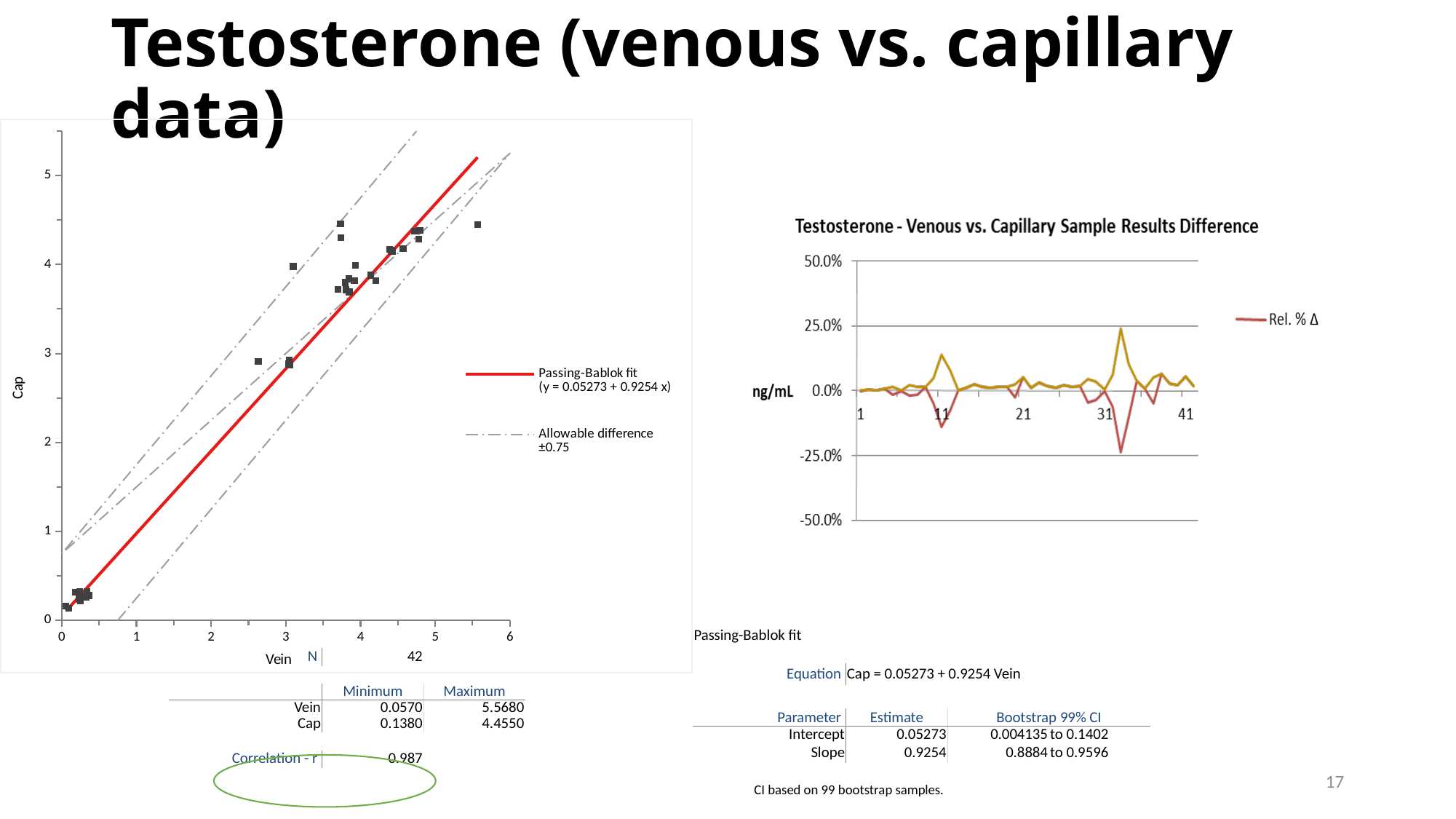
What is the name of the series in the legend of the right chart? Rel. % Δ In the left scatter plot, what allowable difference is shown by the dash-dot lines according to the legend? ±0.75 What is the slope estimate of the Passing-Bablok fit shown for the left scatter plot? 0.9254 In the left scatter plot, what equation is given for the Passing-Bablok fit in the legend? y = 0.05273 + 0.9254 x In the left scatter plot, how many samples (N) are plotted? 42 In the left scatter plot, is the Vein value of the rightmost data point greater or less than 5? greater What kind of chart is the right chart titled 'Testosterone - Venous vs. Capillary Sample Results Difference'? line chart In the right chart, is the lowest point of the Rel. % Δ line greater or less than -50.0%? greater What kind of chart is the left chart with Vein on the x axis and Cap on the y axis? scatter plot In the right chart, is the peak of the Rel. % Δ line near sample 11 greater or less than 25.0%? less How many series does the legend of the right chart list? 1